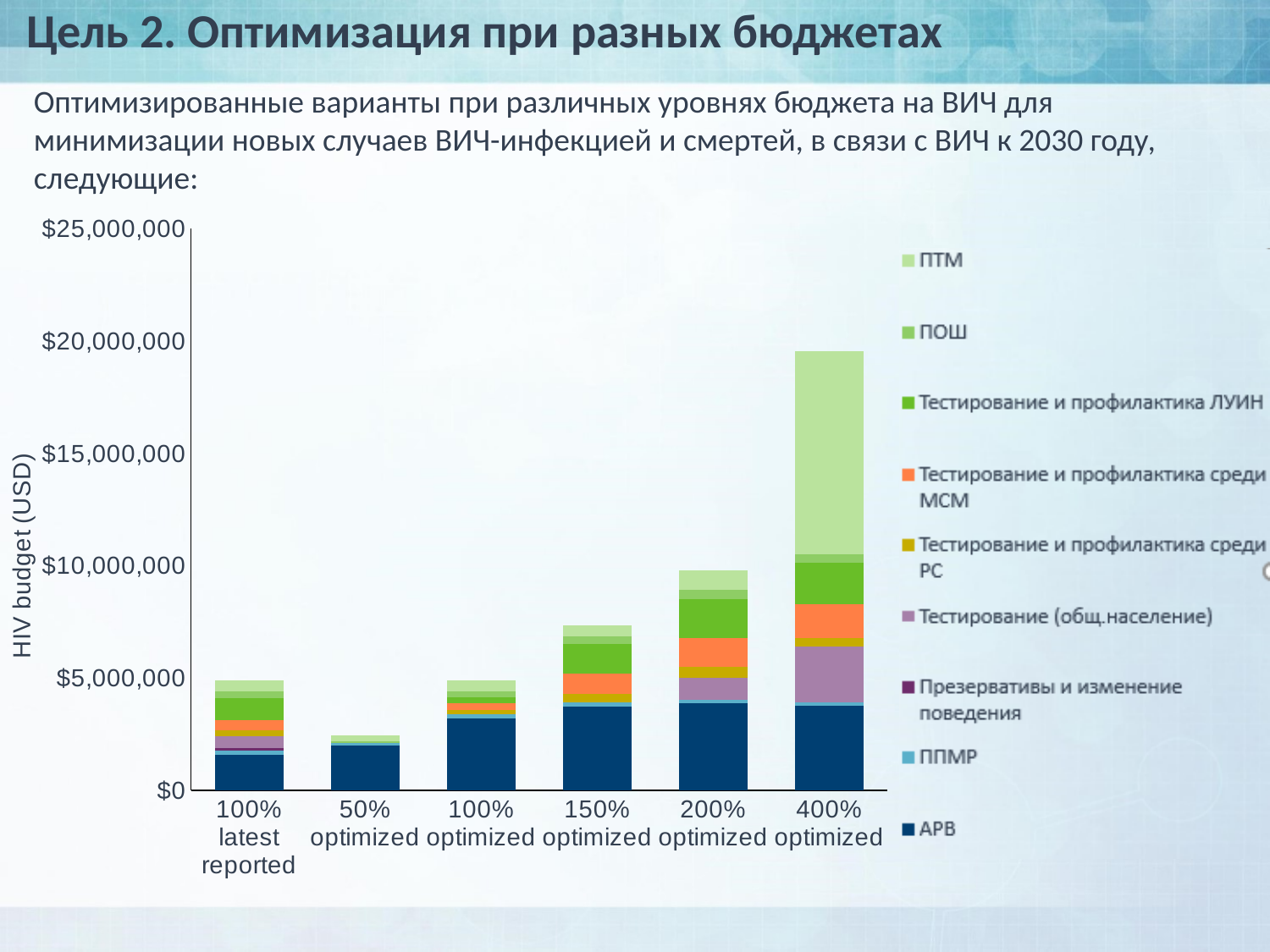
Which budget scenario has the lowest total HIV budget? 50% optimized How many series does the legend list? 9 Is the total value for 150% optimized greater or less than $5,000,000? greater Is the total value for 400% optimized greater or less than $15,000,000? greater Which budget scenario has the highest total HIV budget? 400% optimized Which has a larger total budget: 150% optimized or 100% optimized? 150% optimized Which series is listed last (at the bottom) in the legend? АРВ How many budget scenarios (bars) are shown on the x axis? 6 Do the total bar heights rise or fall from 50% optimized to 400% optimized? rise Is the total value for 50% optimized greater or less than $5,000,000? less What is the label of the vertical axis? HIV budget (USD) What kind of chart is shown on the slide? Stacked bar chart